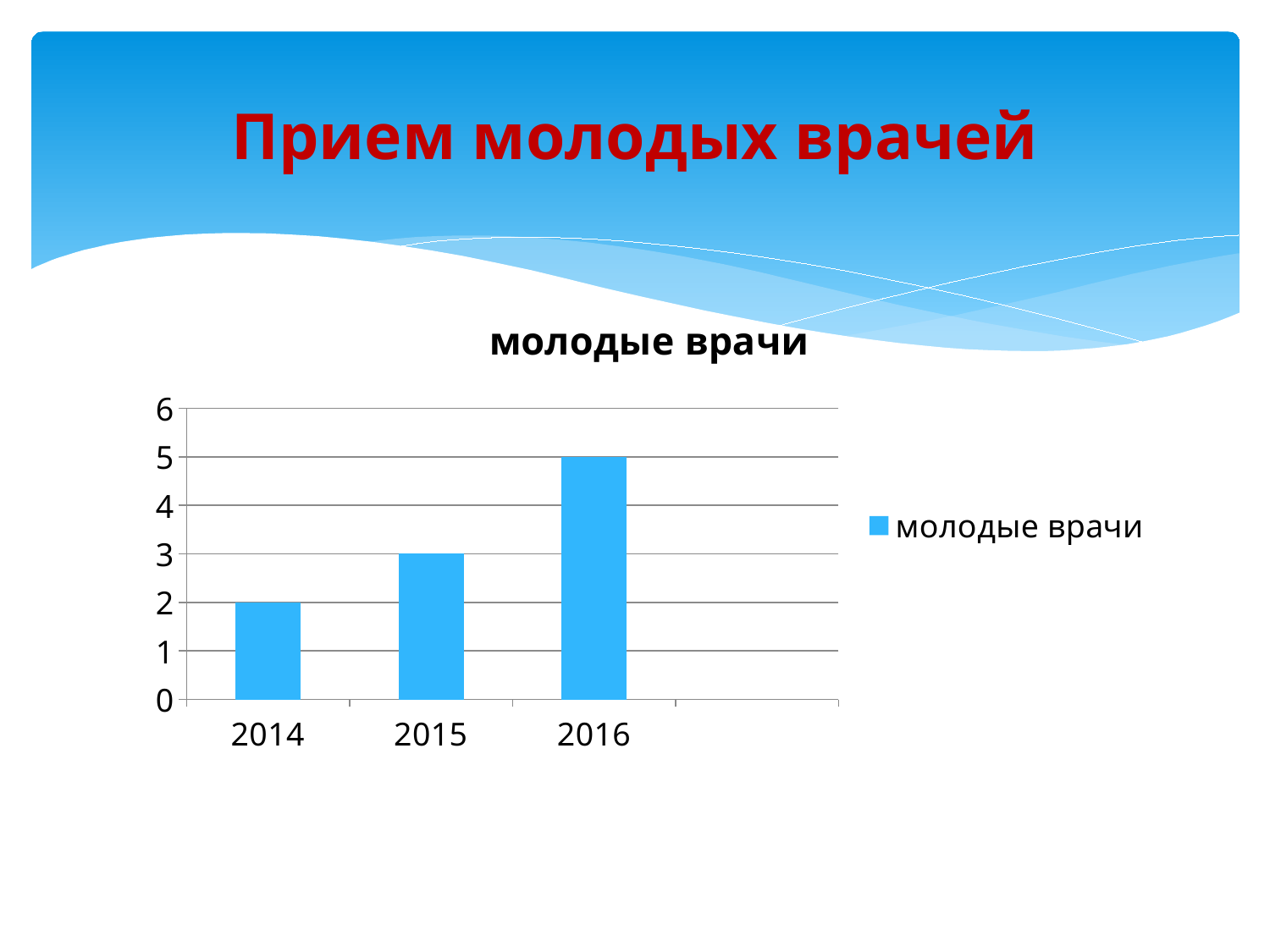
What is the value for 2016 in the chart? 5 Which year has the lowest value in the chart? 2014 Is the value for 2016 greater or less than 4? greater How many years are shown on the x axis of the chart? 3 What is the value for 2015 in the chart? 3 Which is larger, the value for 2015 or the value for 2016? 2016 What is the value for 2014 in the chart? 2 How many series does the legend list? 1 What is the difference between the values for 2016 and 2014? 3 Which year has the highest value in the chart? 2016 Do the values rise or fall from 2014 to 2016? rise What kind of chart is shown on the slide? bar chart